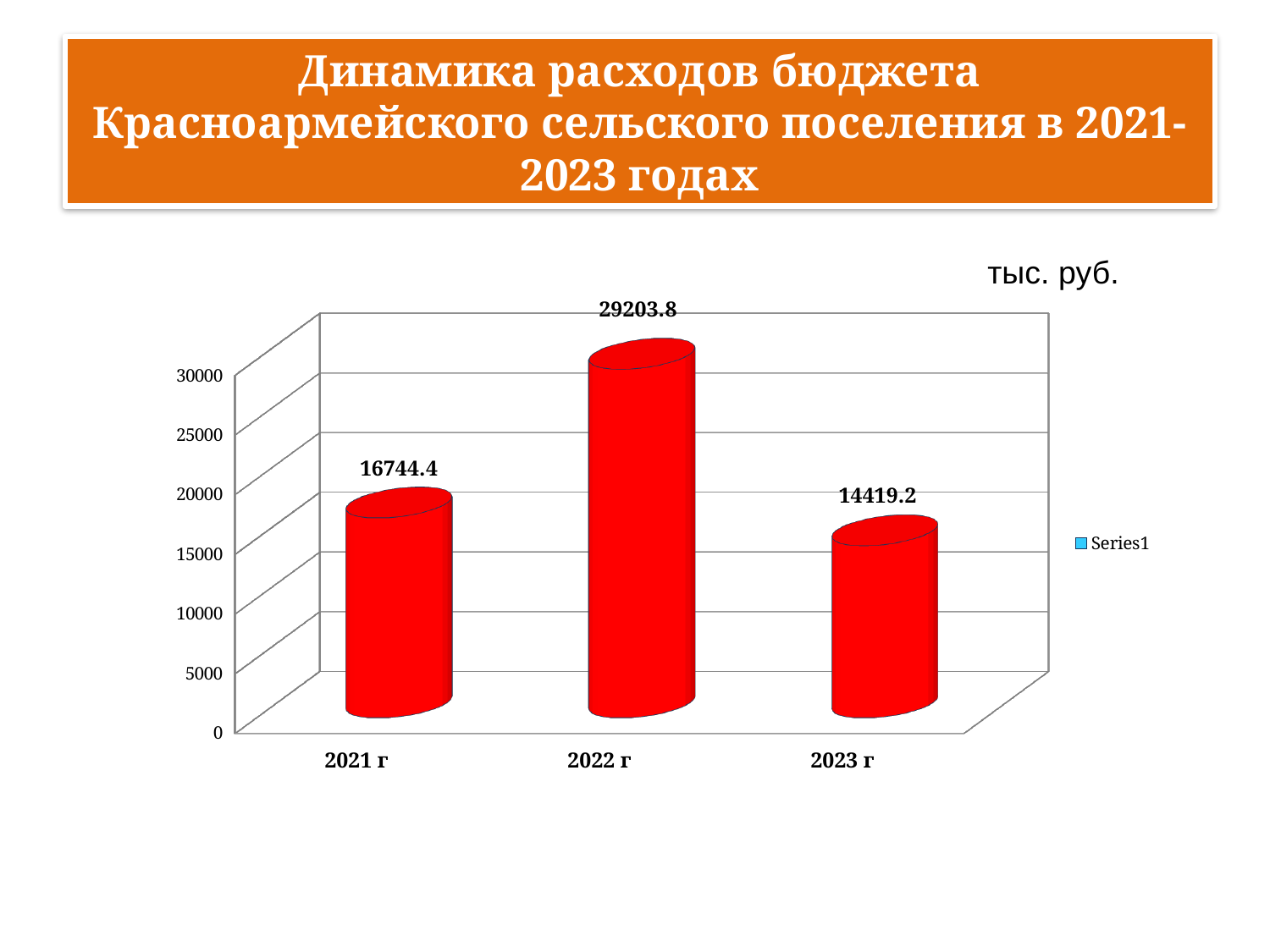
What is the difference between the values for 2022 г and 2021 г? 12459.4 What is the value for 2022 г? 29203.8 What is the difference between the values for 2021 г and 2023 г? 2325.2 What is the value for 2021 г? 16744.4 What unit is indicated above the chart? тыс. руб. How many years are shown on the chart? 3 Is the value for 2022 г greater or less than 25000? greater Which is larger, the value for 2021 г or the value for 2023 г? 2021 г What is the value for 2023 г? 14419.2 What kind of chart is shown on the slide? bar chart Which year has the lowest value? 2023 г Which year has the highest value? 2022 г